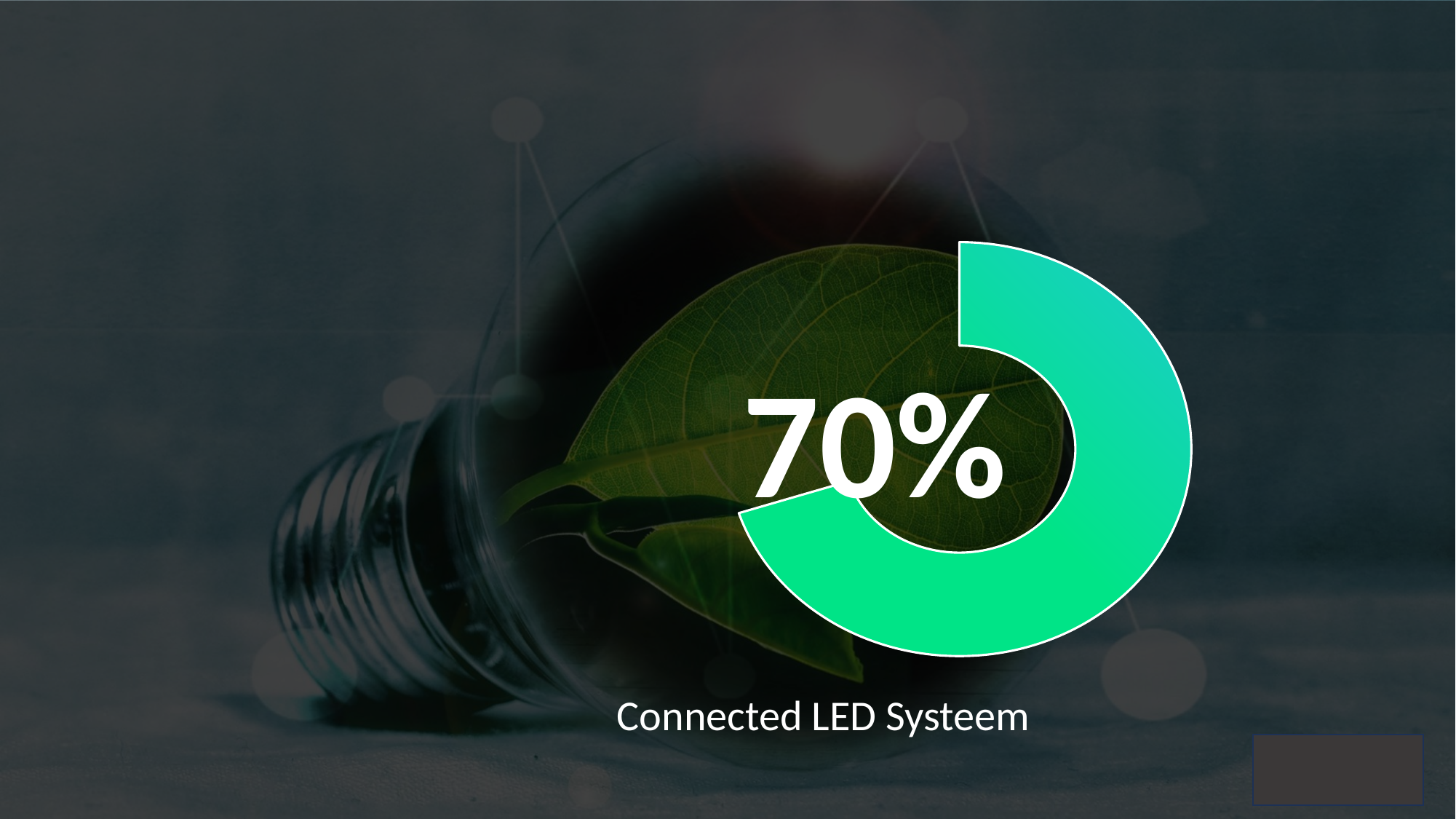
How many values are displayed on the donut chart? 1 What label appears beneath the donut chart? Connected LED Systeem What percentage is shown in the centre of the donut chart? 70% What share of the ring is filled for Connected LED Systeem? 70% What colour is the filled portion of the donut chart? Green Is the value shown for Connected LED Systeem greater or less than 50%? greater What kind of chart is shown on the slide? Donut chart